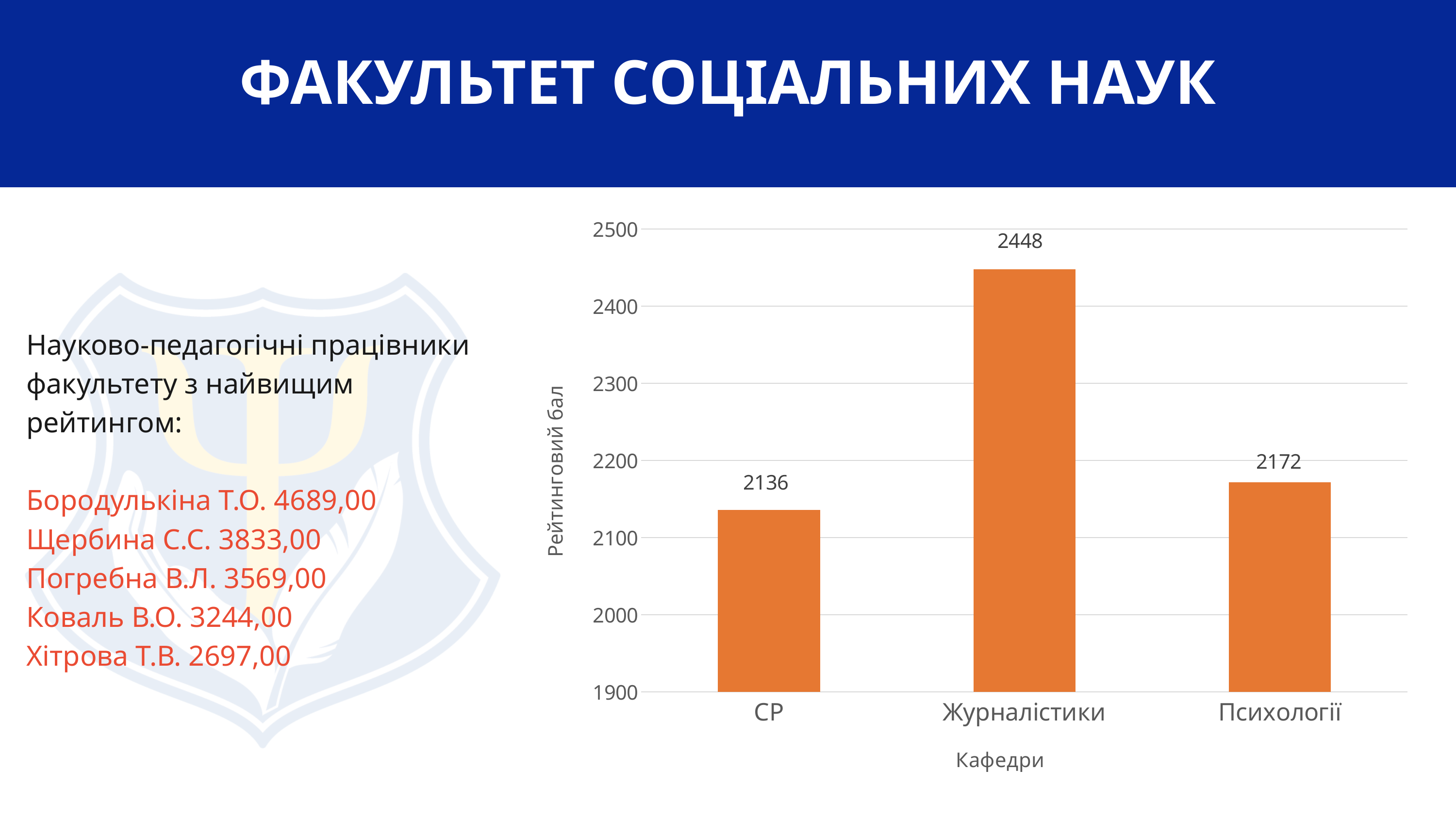
Is the value for Журналістики greater or less than 2400? greater What kind of chart is shown on the slide? bar chart Which has a higher rating score, Психології or СР? Психології What is the rating score (Рейтинговий бал) for the СР department? 2136 What is the difference between the rating scores of Журналістики and СР? 312 How many departments are shown on the chart? 3 What is the rating score for the Психології department? 2172 What is the difference between the rating scores of Психології and СР? 36 What is the label of the x axis of the chart? Кафедри Which department has the lowest rating score? СР What is the rating score for the Журналістики department? 2448 Which department has the highest rating score? Журналістики